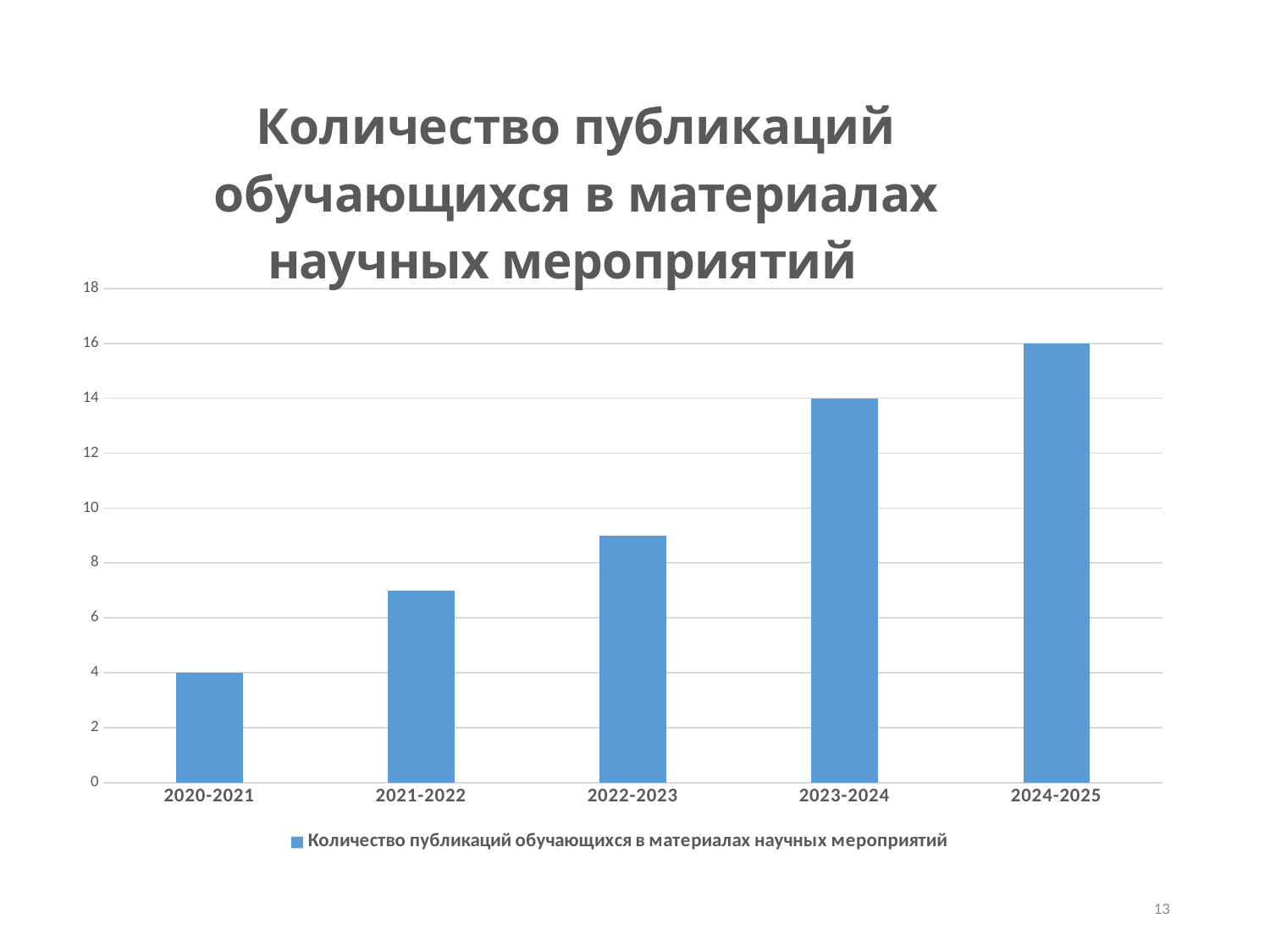
What is the value for 2024-2025? 16 Is the value for 2022-2023 greater or less than 10? less Which is larger, the value for 2021-2022 or the value for 2023-2024? 2023-2024 What is the difference between the values for 2024-2025 and 2020-2021? 12 How many academic years are shown on the x axis? 5 Do the values rise or fall from 2020-2021 to 2024-2025? rise What is the value for 2020-2021? 4 Is the value for 2021-2022 greater or less than 6? greater What is the value for 2023-2024? 14 What is the difference between the values for 2024-2025 and 2023-2024? 2 Which academic year has the highest number of publications? 2024-2025 Which academic year has the lowest number of publications? 2020-2021